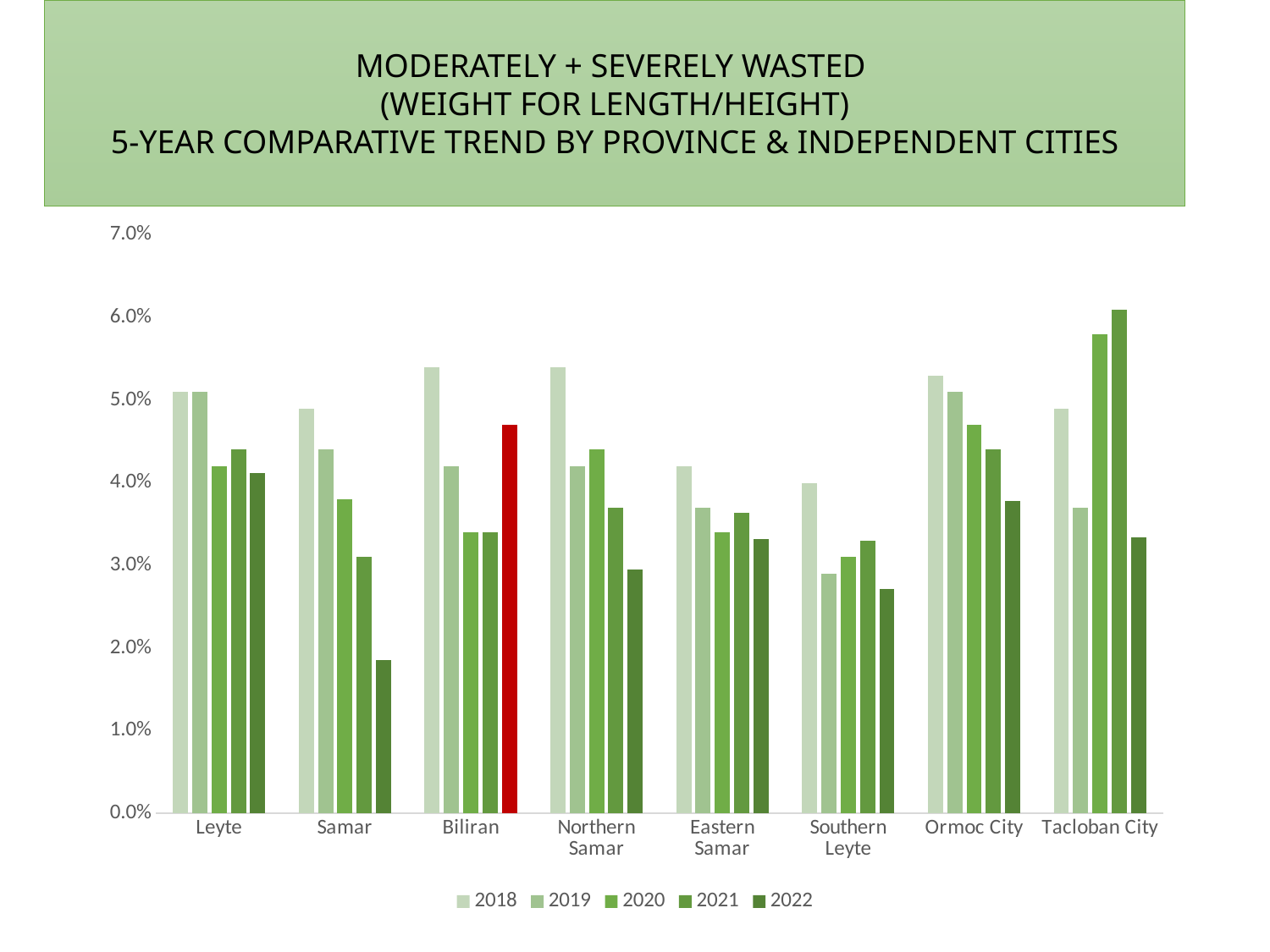
Is the 2022 value for Samar greater or less than 2.0%? less Which is larger, the 2021 value for Tacloban City or the 2021 value for Leyte? Tacloban City Is the 2022 value for Southern Leyte greater or less than 3.0%? less Which province or city has the highest value for 2022? Biliran Which province or city has the tallest bar in the whole chart? Tacloban City Which province or city has the lowest value for 2022? Samar How many series does the legend list? 5 What kind of chart is shown on the slide? Bar chart Which bar is coloured red in the chart? Biliran 2022 Do the values for Samar rise or fall from 2018 to 2022? fall Is the 2020 value for Tacloban City greater or less than 5.0%? greater How many provinces and cities are shown on the x axis? 8